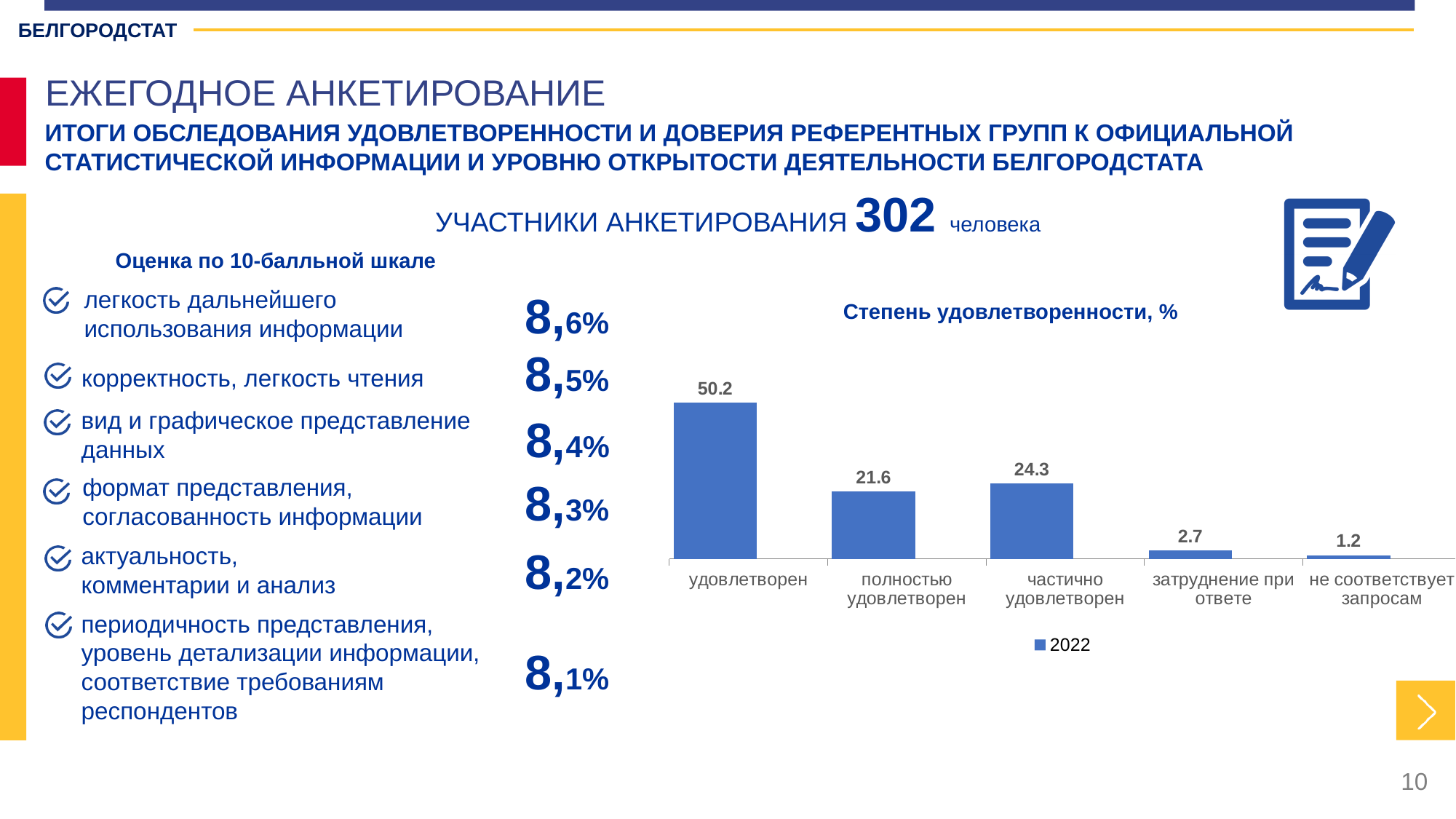
What is the value for "затруднение при ответе" in the chart? 2.7 How many series does the chart legend list? 1 What is the value for "удовлетворен" in the chart "Степень удовлетворенности, %"? 50.2 What is the value for "не соответствует запросам" in the chart? 1.2 What is the value for "частично удовлетворен" in the chart? 24.3 Which category has the highest value in the chart "Степень удовлетворенности, %"? удовлетворен What type of chart is "Степень удовлетворенности, %"? bar chart How many categories are shown in the chart "Степень удовлетворенности, %"? 5 Which category has the lowest value in the chart? не соответствует запросам Which is larger: the value for "частично удовлетворен" or "полностью удовлетворен"? частично удовлетворен What is the difference between the values for "удовлетворен" and "частично удовлетворен"? 25.9 What is the value for "полностью удовлетворен" in the chart? 21.6